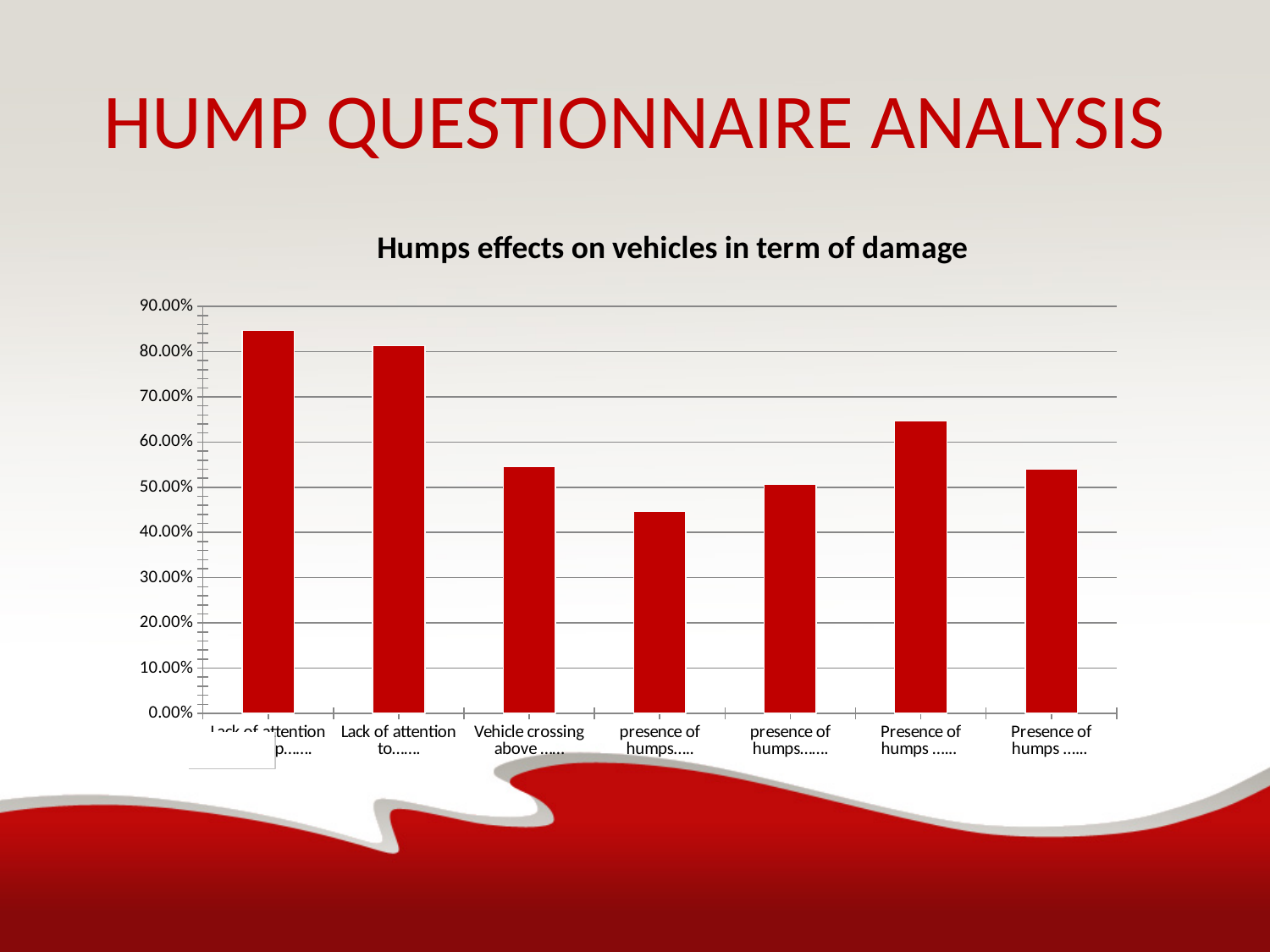
Is the value of the third bar (Vehicle crossing above ......) greater or less than 50.00%? greater Which is larger, the value of the second bar (Lack of attention to......) or the fourth bar (presence of humps.....)? the second bar (Lack of attention to......) What kind of chart is shown on the slide? bar chart Is the value of the fourth bar (presence of humps.....) greater or less than 50.00%? less Which bar is the lowest in the chart? the fourth bar (presence of humps.....) What is the title of the chart? Humps effects on vehicles in term of damage Is the value of the first bar (Lack of attention p......) greater or less than 80.00%? greater Which bar is the highest in the chart? the first bar (Lack of attention p......) Which is larger, the value of the sixth bar (Presence of humps ......) or the third bar (Vehicle crossing above ......)? the sixth bar (Presence of humps ......) What colour are the bars in the chart? red How many bars are plotted in the chart? 7